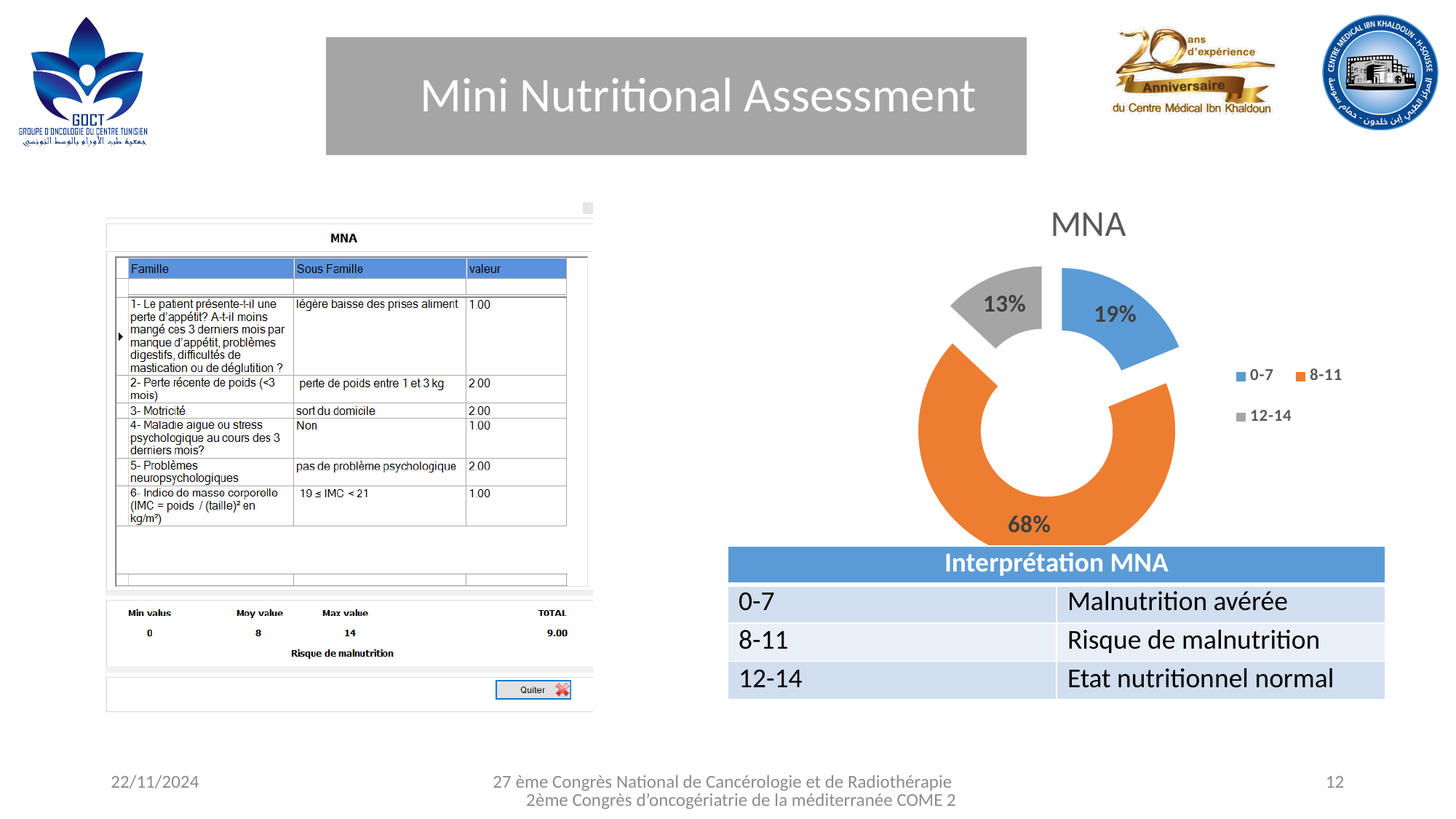
Which category has the largest share in the MNA chart? 8-11 What percentage does the 0-7 category represent in the MNA chart? 19% What colour represents the 8-11 category in the MNA chart? orange What percentage does the 8-11 category represent in the MNA chart? 68% What is the combined share of the 0-7 and 12-14 categories in the MNA chart? 32% In the MNA chart, which is larger: the share for 0-7 or the share for 12-14? 0-7 What kind of chart is the MNA chart? doughnut chart How many categories does the MNA chart show? 3 What is the title of the chart on the slide? MNA Which category has the smallest share in the MNA chart? 12-14 What percentage does the 12-14 category represent in the MNA chart? 13% What is the difference in percentage points between the 8-11 and 0-7 shares in the MNA chart? 49